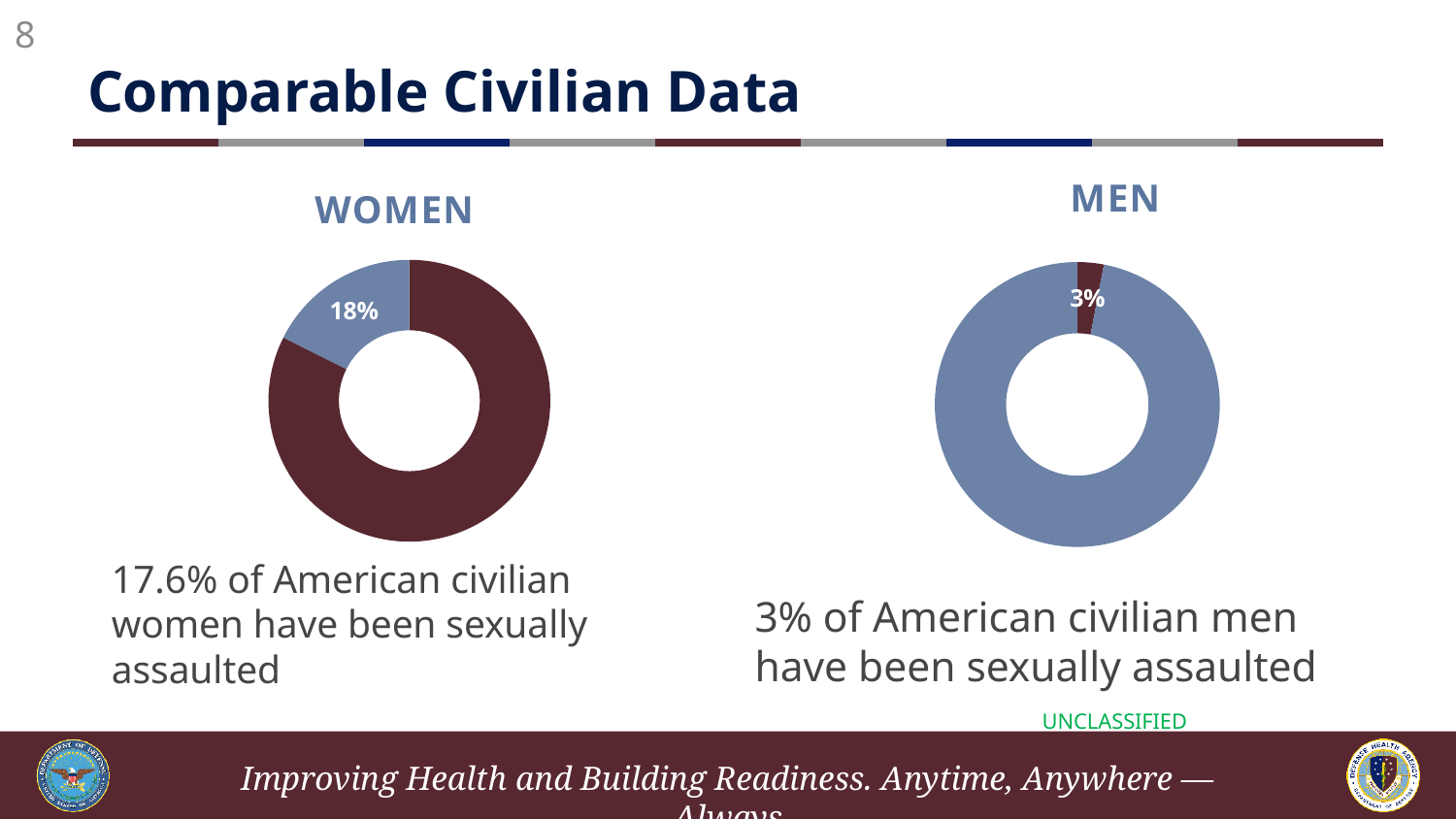
Which labelled value is larger, the 18% in the WOMEN chart or the 3% in the MEN chart? 18% in the WOMEN chart In the WOMEN chart, what percentage is shown on the labelled slice? 18% What kind of chart is used for the MEN data? Donut (pie) chart How many slices does the MEN donut chart have? 2 In the MEN chart, what percentage is shown on the labelled slice? 3% In the WOMEN chart, is the labelled slice the smaller or the larger of the two slices? Smaller How many slices does the WOMEN donut chart have? 2 What is the title of the chart on the left? WOMEN What is the title of the chart on the right? MEN How many charts are shown on the slide? 2 What kind of chart is used for the WOMEN data? Donut (pie) chart What is the difference between the labelled value in the WOMEN chart and the labelled value in the MEN chart? 15 percentage points